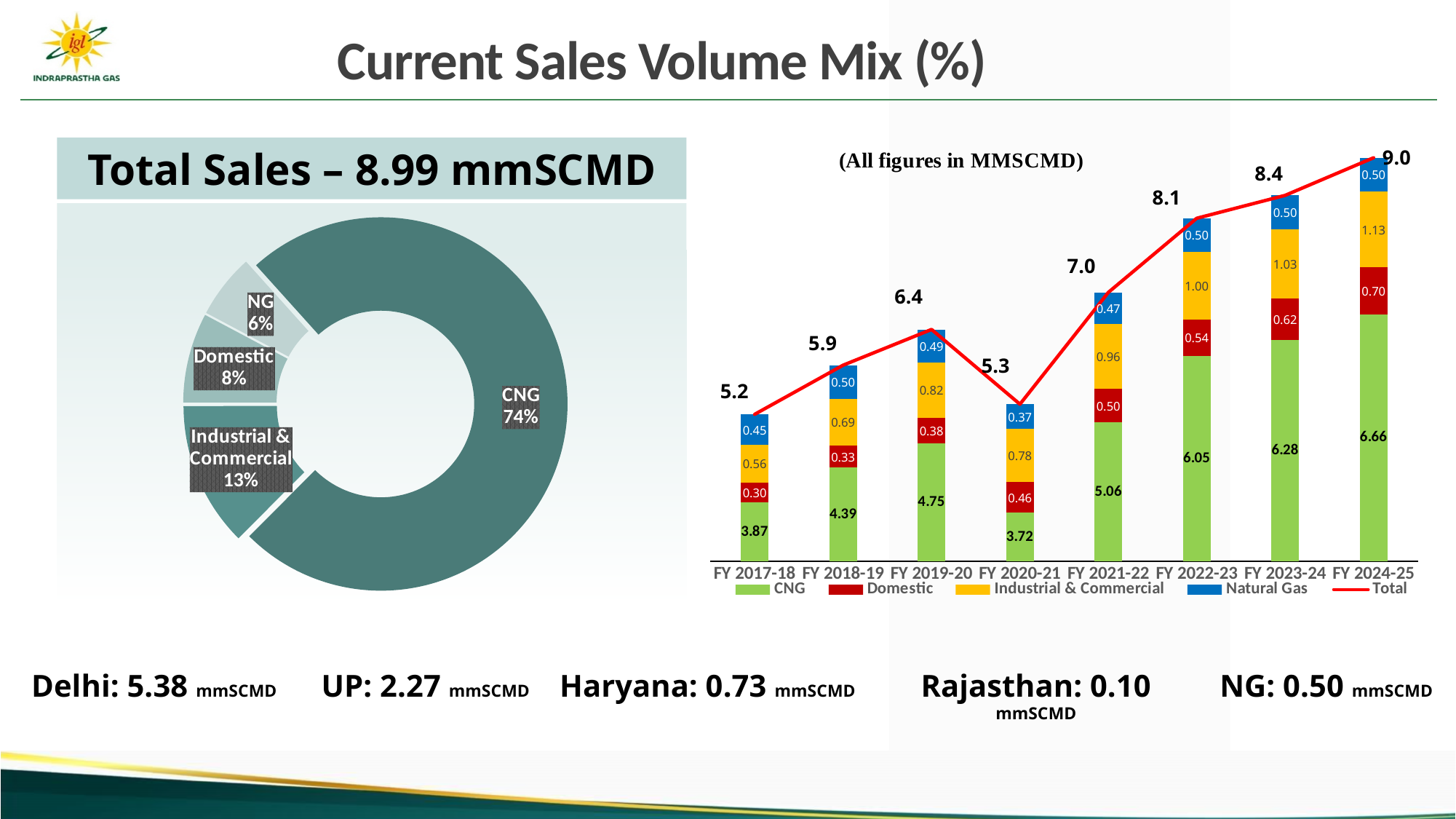
How many series does the legend of the stacked bar chart on the right list? 5 How many fiscal years are shown on the x axis of the stacked bar chart on the right? 8 In the stacked bar chart on the right, what is the Total value for FY 2019-20? 6.4 How many segments does the donut chart on the left have? 4 In the stacked bar chart on the right, what is the Domestic value for FY 2020-21? 0.46 In the stacked bar chart on the right, does the Total line rise or fall from FY 2020-21 to FY 2024-25? Rise In the stacked bar chart on the right, by how much did the CNG value increase from FY 2023-24 to FY 2024-25? 0.38 In the donut chart on the left, what is the share for Industrial & Commercial? 13% In the stacked bar chart on the right, which fiscal year has the lowest Total value? FY 2017-18 In the donut chart on the left, which segment has the smallest share? NG In the donut chart titled 'Total Sales – 8.99 mmSCMD', what share of sales does CNG account for? 74% In the stacked bar chart on the right, what is the CNG value for FY 2024-25? 6.66